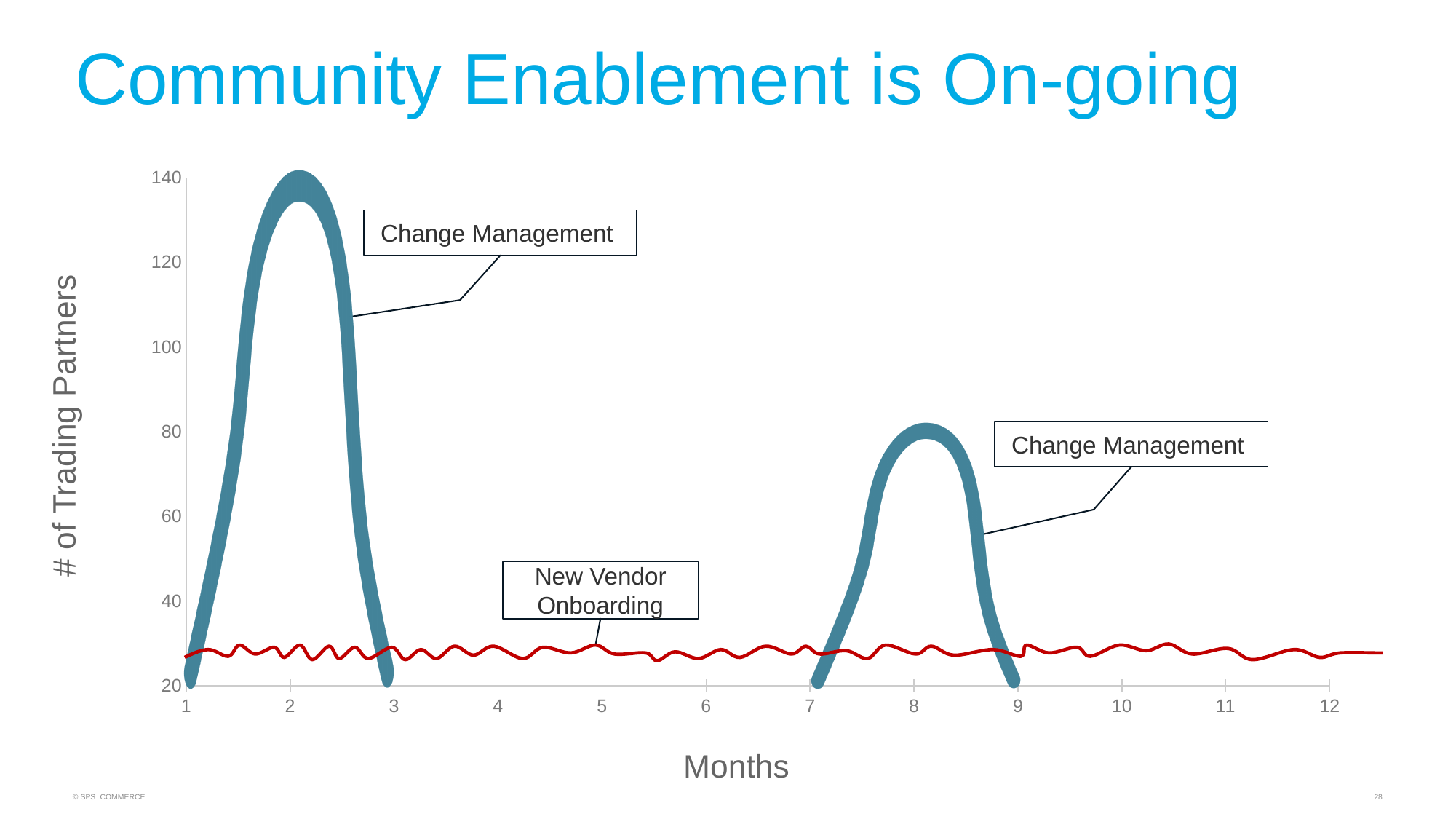
What is the label on the vertical axis of the chart? # of Trading Partners Is the peak value of the second Change Management curve (around month 8) greater or less than 60? greater Is the peak value of the second Change Management curve (around month 8) greater or less than 100? less What is the title of the slide containing the chart? Community Enablement is On-going Which Change Management peak is higher, the one around month 2 or the one around month 8? the one around month 2 Which series is drawn as the red line on the chart? New Vendor Onboarding Is the peak value of the first Change Management curve greater or less than 120? greater Around which month does the first Change Management curve reach its highest point? 2 How many months are marked along the x axis of the chart? 12 Does the New Vendor Onboarding line rise sharply, fall sharply, or stay roughly flat across the months? stays roughly flat What kind of chart is shown on the slide? line chart